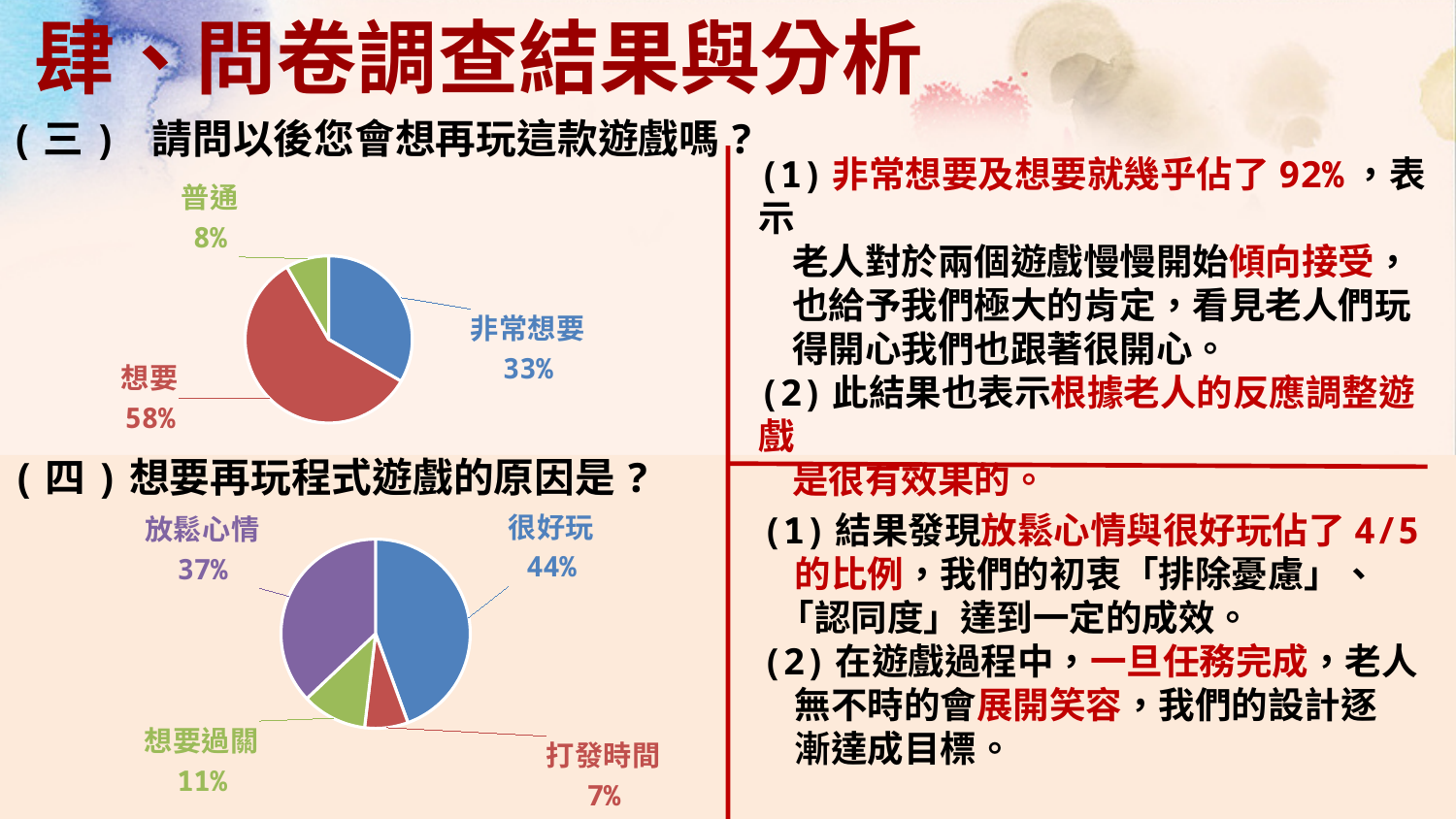
In the top pie chart (請問以後您會想再玩這款遊戲嗎), which category has the largest slice? 想要 In the top pie chart (請問以後您會想再玩這款遊戲嗎), what share is labelled for 非常想要? 33% In the bottom pie chart (想要再玩程式遊戲的原因是), what share is labelled for 很好玩? 44% In the top pie chart (請問以後您會想再玩這款遊戲嗎), how many slices are there? 3 In the top pie chart (請問以後您會想再玩這款遊戲嗎), what is the difference in percentage points between 想要 and 非常想要? 25 What type of chart is used for the bottom chart (想要再玩程式遊戲的原因是)? Pie chart In the bottom pie chart (想要再玩程式遊戲的原因是), which category has the largest slice? 很好玩 In the bottom pie chart (想要再玩程式遊戲的原因是), how many categories are shown? 4 In the bottom pie chart (想要再玩程式遊戲的原因是), which is larger, 放鬆心情 or 想要過關? 放鬆心情 In the top pie chart (請問以後您會想再玩這款遊戲嗎), what share is labelled for 想要? 58% In the bottom pie chart (想要再玩程式遊戲的原因是), what share is labelled for 打發時間? 7% In the top pie chart (請問以後您會想再玩這款遊戲嗎), which category has the smallest slice? 普通